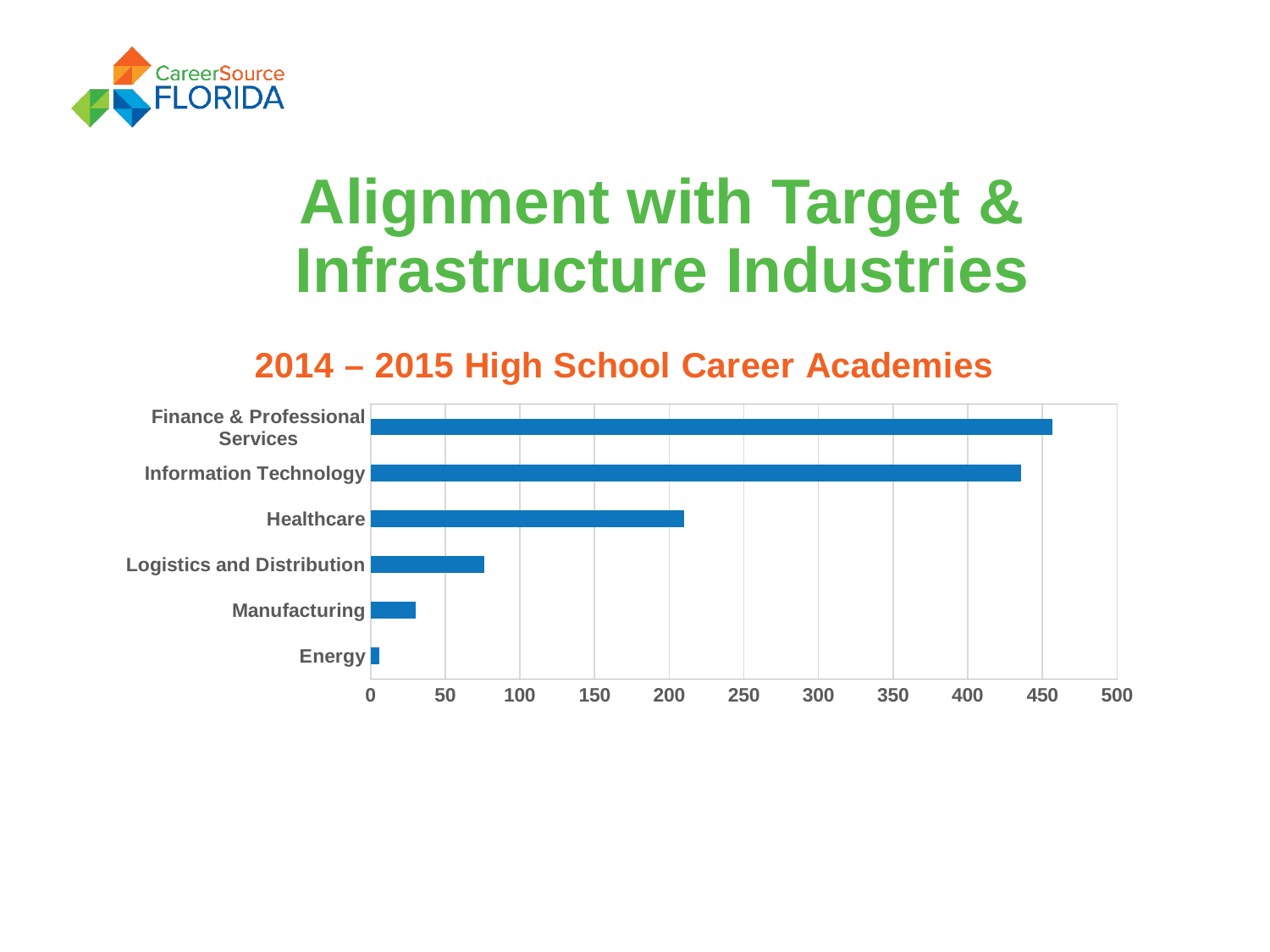
What is the maximum value shown on the horizontal axis? 500 Is the value for Healthcare greater or less than 200? greater What kind of chart is shown on the slide? bar chart What is the title of the chart? 2014 – 2015 High School Career Academies Is the value for Information Technology greater or less than 400? greater Is the value for Manufacturing greater or less than 50? less Which category has the highest value? Finance & Professional Services Which is larger, the value for Healthcare or the value for Logistics and Distribution? Healthcare Which category has the lowest value? Energy How many categories are shown in the chart? 6